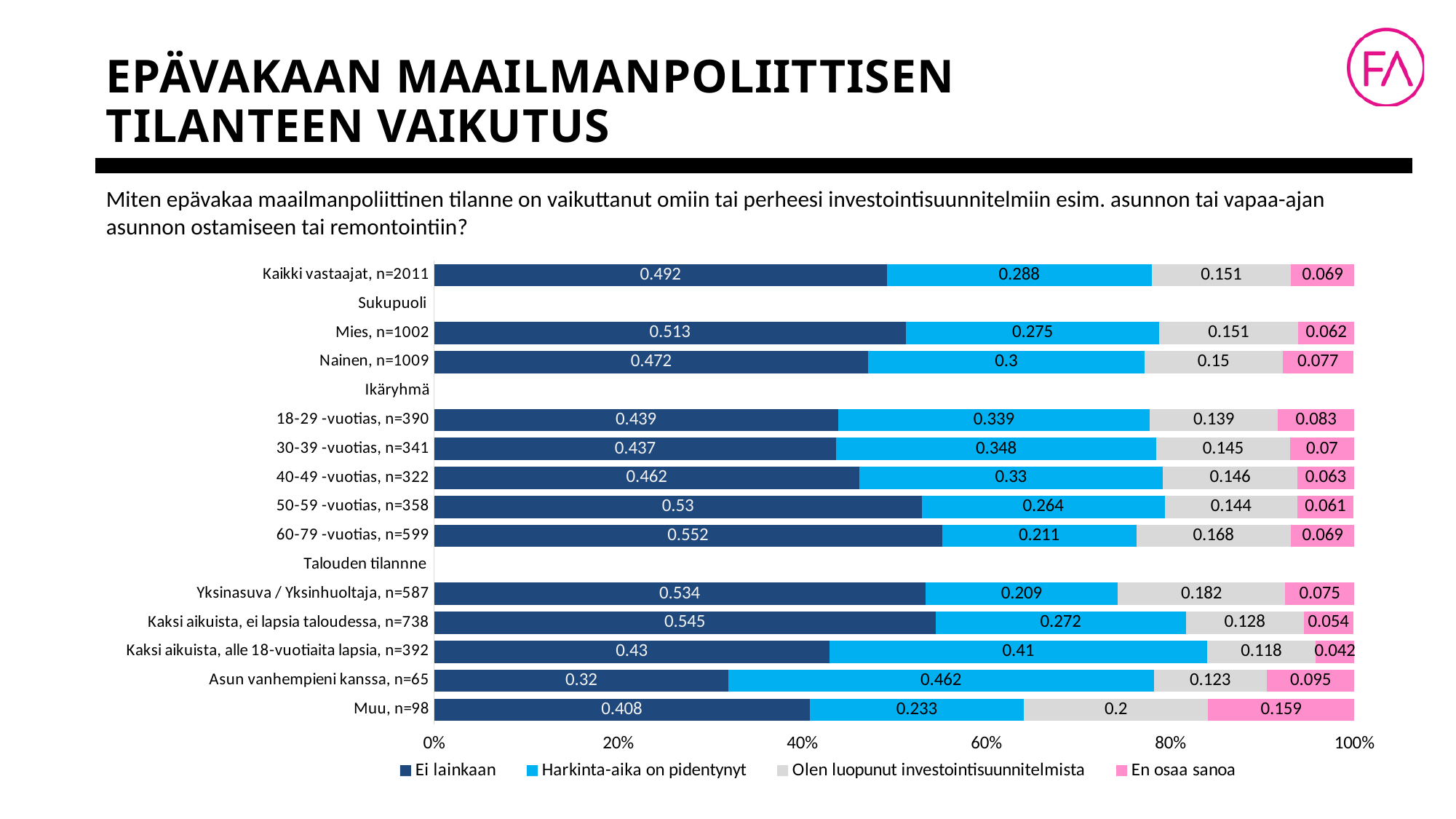
How many series does the legend list? 4 What kind of chart is shown on the slide? Stacked bar chart Which category has the lowest value for 'Ei lainkaan'? Asun vanhempieni kanssa, n=65 Which category has the highest value for 'Ei lainkaan'? 60-79 -vuotias, n=599 What is the difference between the 'Ei lainkaan' values for 'Mies, n=1002' and 'Nainen, n=1009'? 0.041 What is the value of 'Ei lainkaan' for 'Kaikki vastaajat, n=2011'? 0.492 Is the 'Ei lainkaan' value for 'Asun vanhempieni kanssa, n=65' greater or less than 40%? less What is the value of 'Harkinta-aika on pidentynyt' for 'Asun vanhempieni kanssa, n=65'? 0.462 What is the value of 'Olen luopunut investointisuunnitelmista' for 'Yksinasuva / Yksinhuoltaja, n=587'? 0.182 Which is larger: the 'Harkinta-aika on pidentynyt' value for '18-29 -vuotias, n=390' or for '60-79 -vuotias, n=599'? 18-29 -vuotias, n=390 How many categories have bars plotted in the chart? 13 What is the value of 'En osaa sanoa' for 'Muu, n=98'? 0.159